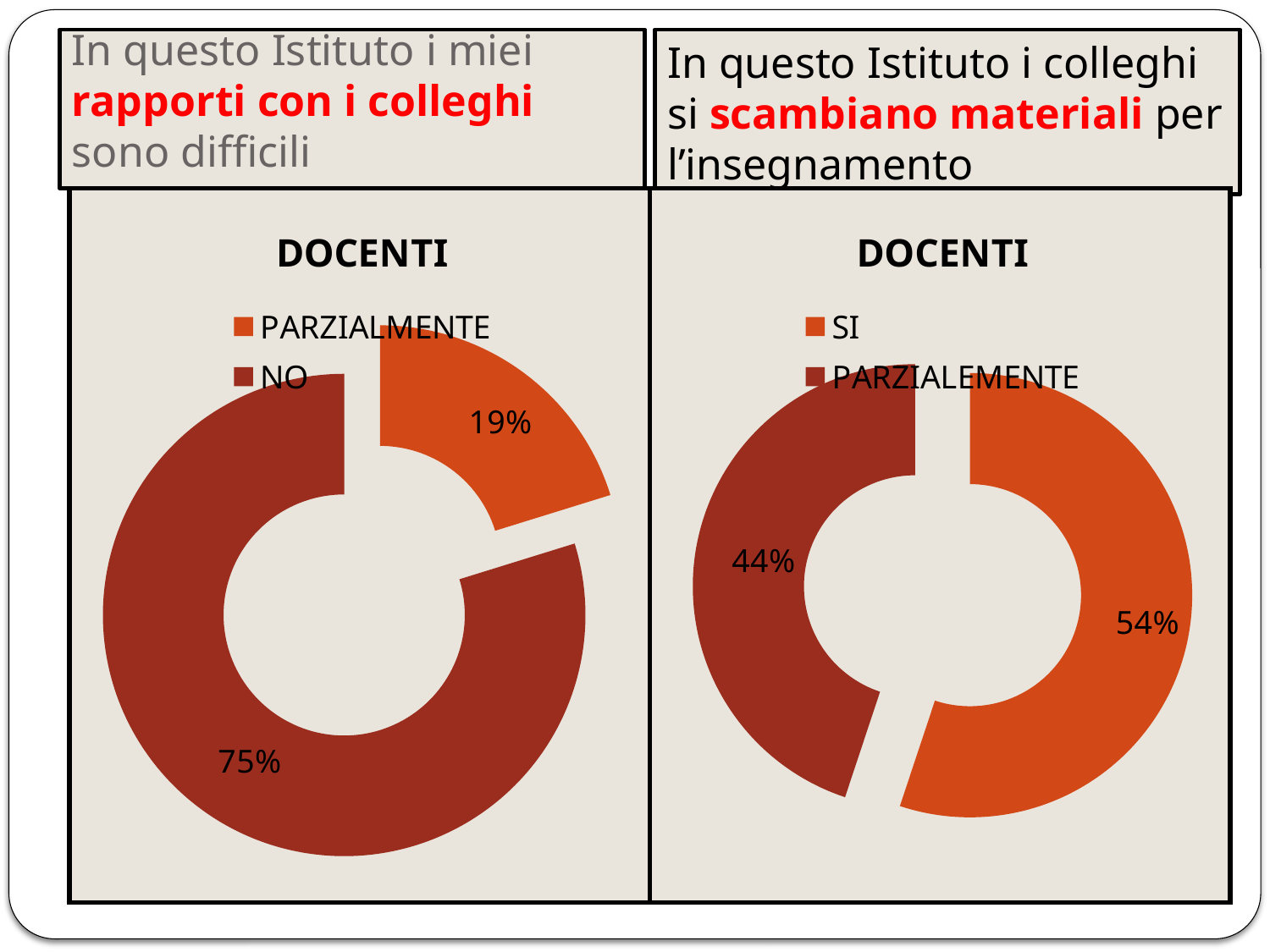
In the left chart, what percentage is shown for PARZIALMENTE? 19% What is the title of the right chart? DOCENTI How many categories does the legend of the right chart list? 2 In the right chart, which category has the smallest share? PARZIALEMENTE What kind of chart is the left chart? Doughnut chart In the left chart, which category has the largest share? NO In the right chart, what percentage is shown for SI? 54% In the left chart, what is the difference in percentage points between NO and PARZIALMENTE? 56 In the right chart, which is larger, SI or PARZIALEMENTE? SI In the right chart, what is the difference in percentage points between SI and PARZIALEMENTE? 10 In the right chart, what percentage is shown for PARZIALEMENTE? 44% In the left chart, what percentage is shown for NO? 75%